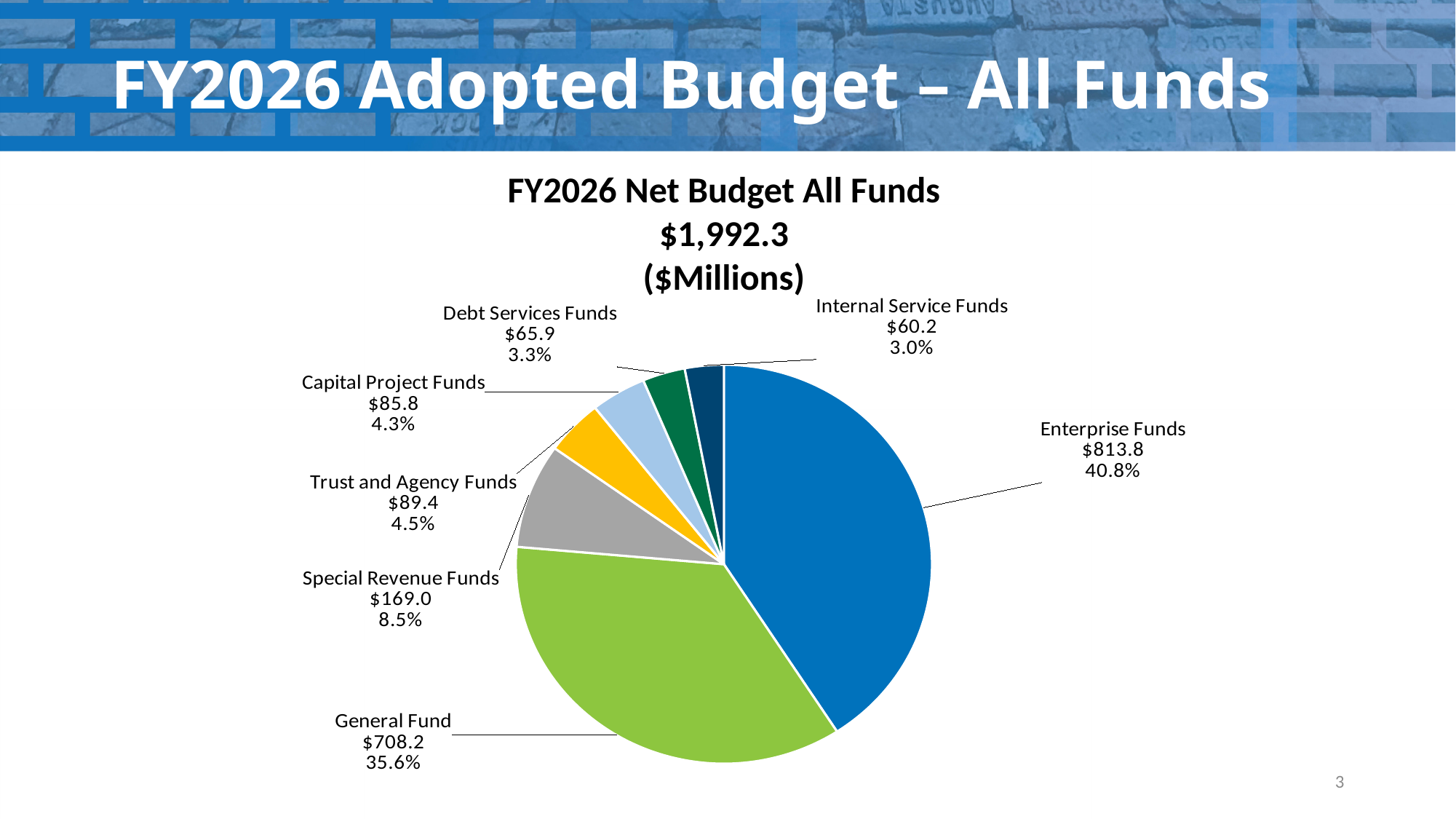
What type of chart is shown on the slide? Pie chart What is the value for the General Fund? $708.2 What is the difference between the Enterprise Funds value and the General Fund value? $105.6 Which is larger, Capital Project Funds or Debt Services Funds? Capital Project Funds Which fund category has the smallest slice of the pie? Internal Service Funds What share of the pie do Trust and Agency Funds represent? 4.5% How many fund categories are shown in the pie chart? 7 What is the value for Enterprise Funds? $813.8 What is the value for Special Revenue Funds? $169.0 Which fund category has the largest slice of the pie? Enterprise Funds What share of the pie do Internal Service Funds represent? 3.0% What total net budget is stated in the chart title? $1,992.3